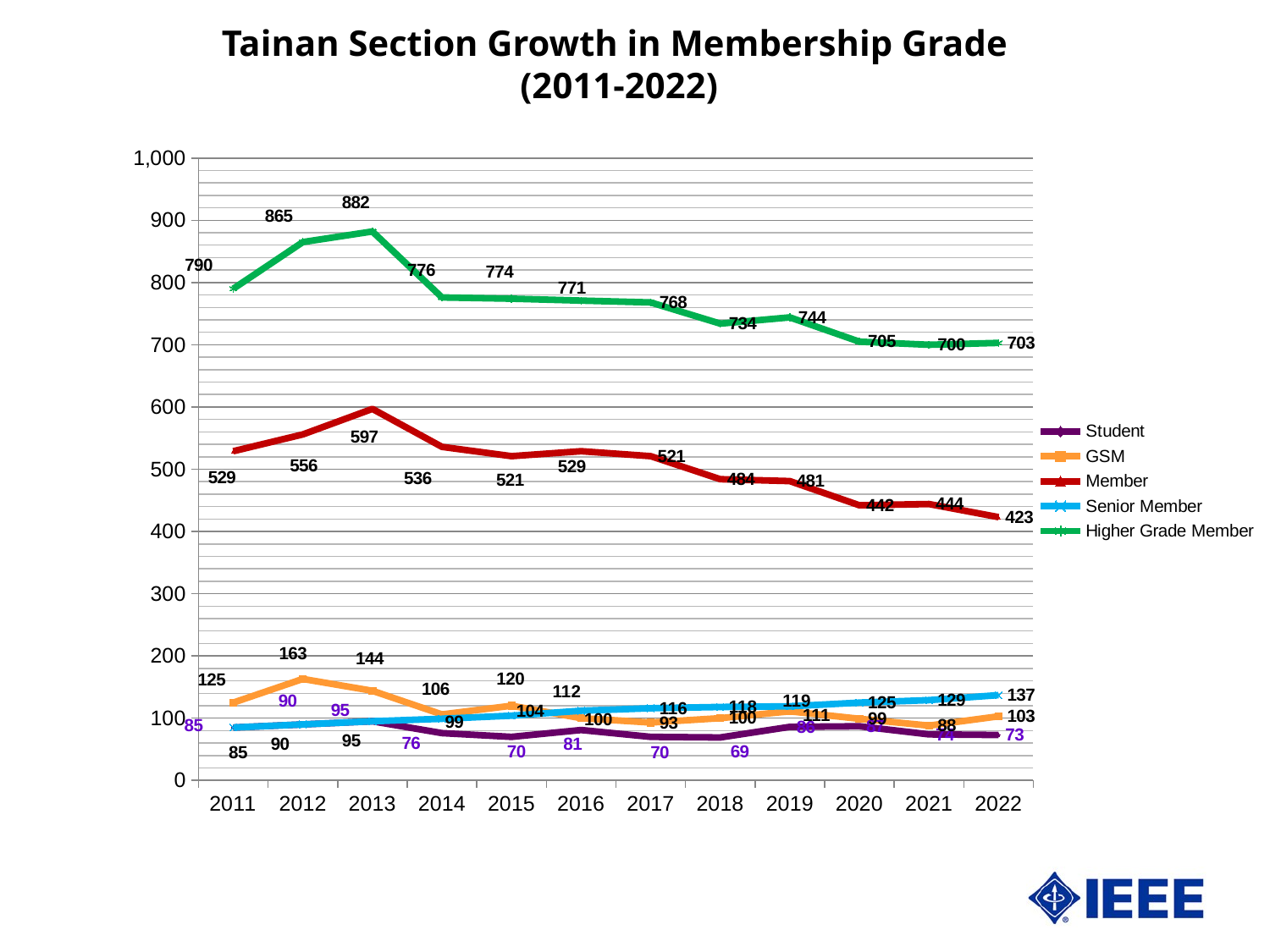
In which year is the Member value lowest? 2022 Which is larger, the Member value for 2013 or the Member value for 2012? 2013 How many years are plotted along the x axis? 12 What is the Senior Member value for 2022? 137 How many series does the legend list? 5 What is the Member value for 2022? 423 What is the GSM value for 2012? 163 What is the difference between the Higher Grade Member values for 2011 and 2022? 87 Does the Member series generally rise or fall from 2013 to 2022? fall What type of chart is shown on the slide? line chart In which year is the Higher Grade Member value highest? 2013 What is the Higher Grade Member value for 2013? 882